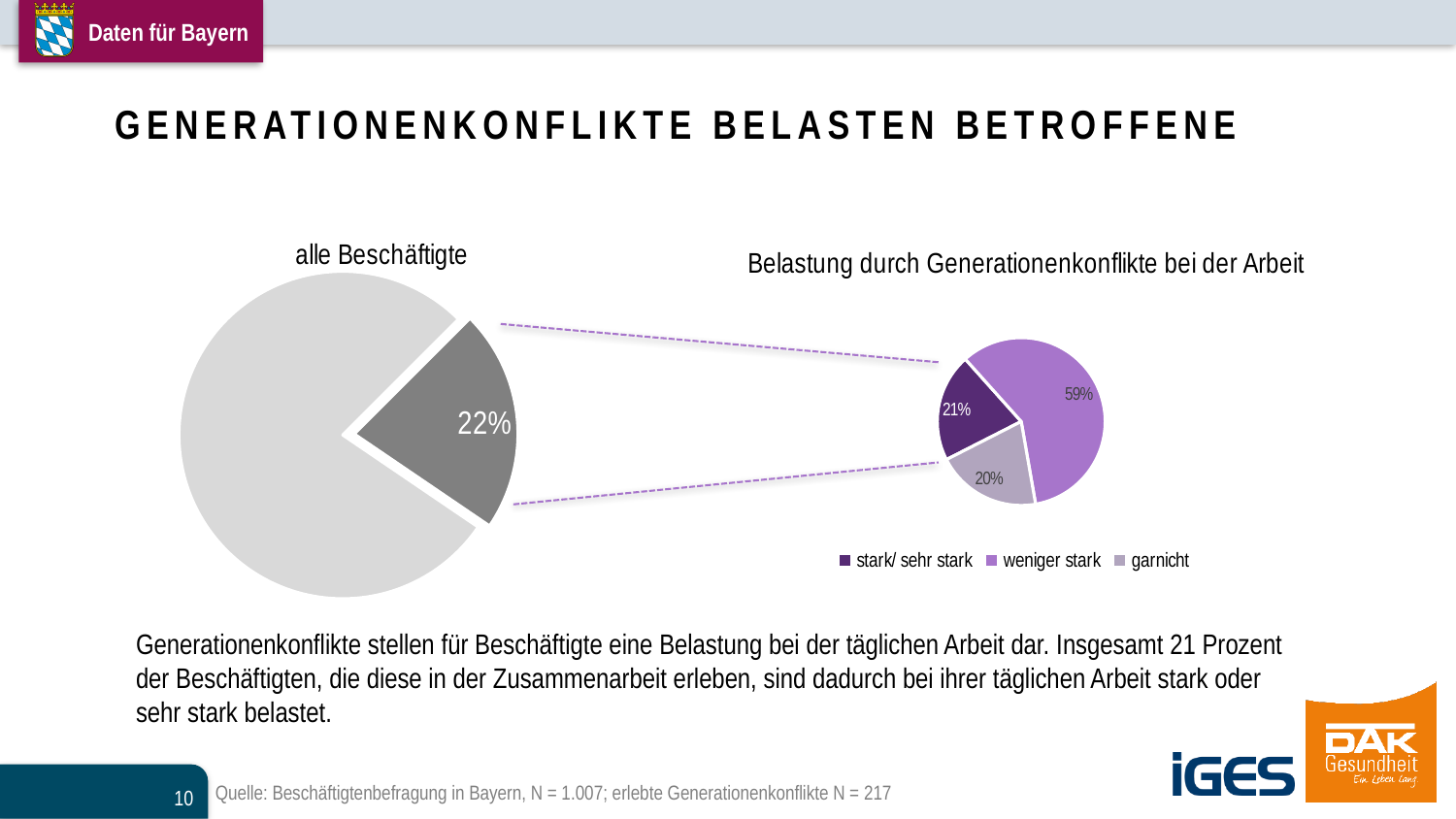
In the chart titled "Belastung durch Generationenkonflikte bei der Arbeit", is the share for "weniger stark" greater or less than 50%? greater In the chart titled "alle Beschäftigte", what percentage is shown on the exploded (separated) slice? 22% How many pie charts are shown on the slide? 2 In the chart titled "Belastung durch Generationenkonflikte bei der Arbeit", what share of respondents answered "stark/ sehr stark"? 21% In the chart titled "Belastung durch Generationenkonflikte bei der Arbeit", what share of respondents answered "garnicht"? 20% In the chart titled "Belastung durch Generationenkonflikte bei der Arbeit", which category has the largest share? weniger stark What kind of chart is the chart titled "alle Beschäftigte"? Pie chart In the chart titled "alle Beschäftigte", is the labelled 22% slice larger or smaller than the unlabelled remaining slice? smaller In the chart titled "Belastung durch Generationenkonflikte bei der Arbeit", what is the difference in percentage points between "weniger stark" and "garnicht"? 39 percentage points In the chart titled "Belastung durch Generationenkonflikte bei der Arbeit", how many categories does the legend list? 3 In the chart titled "Belastung durch Generationenkonflikte bei der Arbeit", which legend entry is shown in the darkest purple? stark/ sehr stark In the chart titled "Belastung durch Generationenkonflikte bei der Arbeit", what share of respondents answered "weniger stark"? 59%